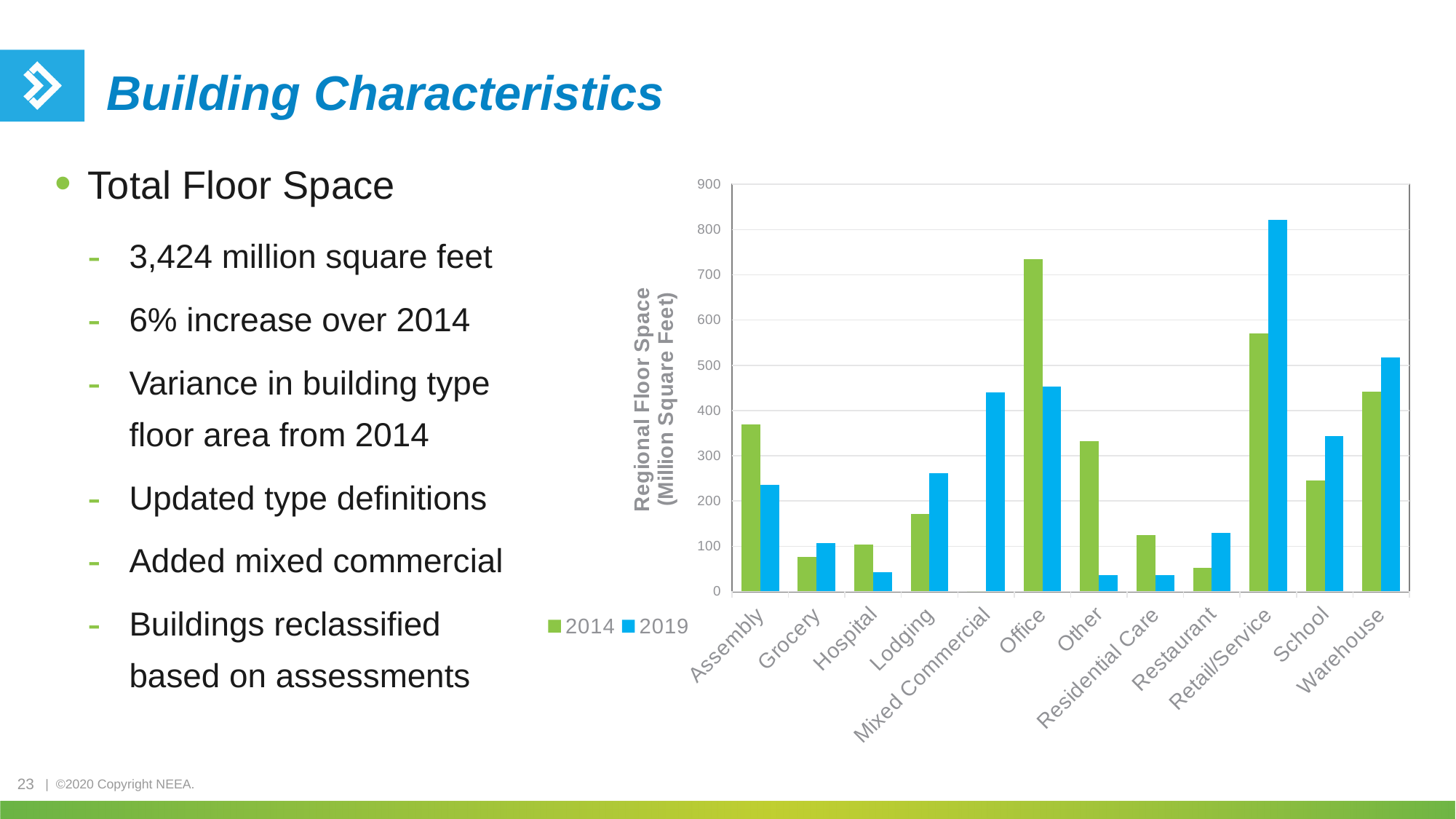
How many series does the chart legend list? 2 Which building type has the highest 2019 regional floor space? Retail/Service For Warehouse, which year has the larger regional floor space, 2014 or 2019? 2019 How many building type categories are shown on the x axis of the chart? 12 Is the 2019 value for Retail/Service greater or less than 800? greater Which building type has the highest 2014 regional floor space? Office What kind of chart is shown on the slide? Bar chart For Assembly, which year has the larger regional floor space, 2014 or 2019? 2014 Is the 2014 value for Office greater or less than 700? greater Which building type has a 2019 bar but no 2014 bar in the chart? Mixed Commercial Is the 2019 value for Hospital greater or less than 100? less